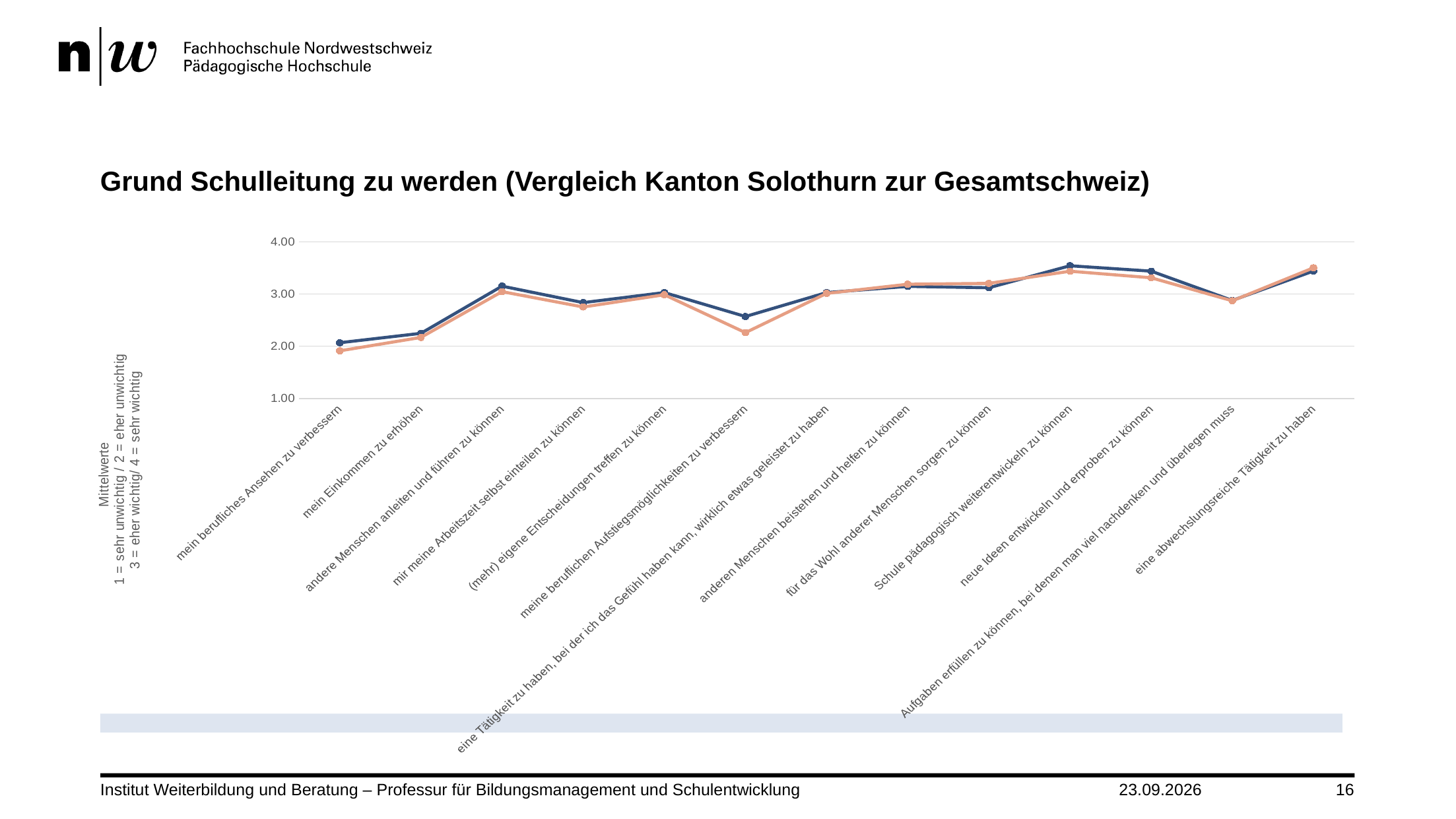
How many lines are plotted in the chart? 2 How many categories (reasons) are plotted along the x axis? 13 Is the value of the orange line for 'meine beruflichen Aufstiegsmöglichkeiten zu verbessern' greater or less than 3.00? less What kind of chart is shown on the slide? line chart Which category has the lowest value on the dark blue line? mein berufliches Ansehen zu verbessern Is the value of the dark blue line for 'Schule pädagogisch weiterentwickeln zu können' greater or less than 3.00? greater Is the value of the dark blue line for 'mein Einkommen zu erhöhen' greater or less than 3.00? less Which category has the lowest value on the orange line? mein berufliches Ansehen zu verbessern For 'meine beruflichen Aufstiegsmöglichkeiten zu verbessern', which line has the higher value, the dark blue or the orange one? dark blue What is the title of the chart on the slide? Grund Schulleitung zu werden (Vergleich Kanton Solothurn zur Gesamtschweiz) On the dark blue line, which is higher: 'mein Einkommen zu erhöhen' or 'andere Menschen anleiten und führen zu können'? andere Menschen anleiten und führen zu können Do the values generally rise or fall from the left to the right of the x axis? rise